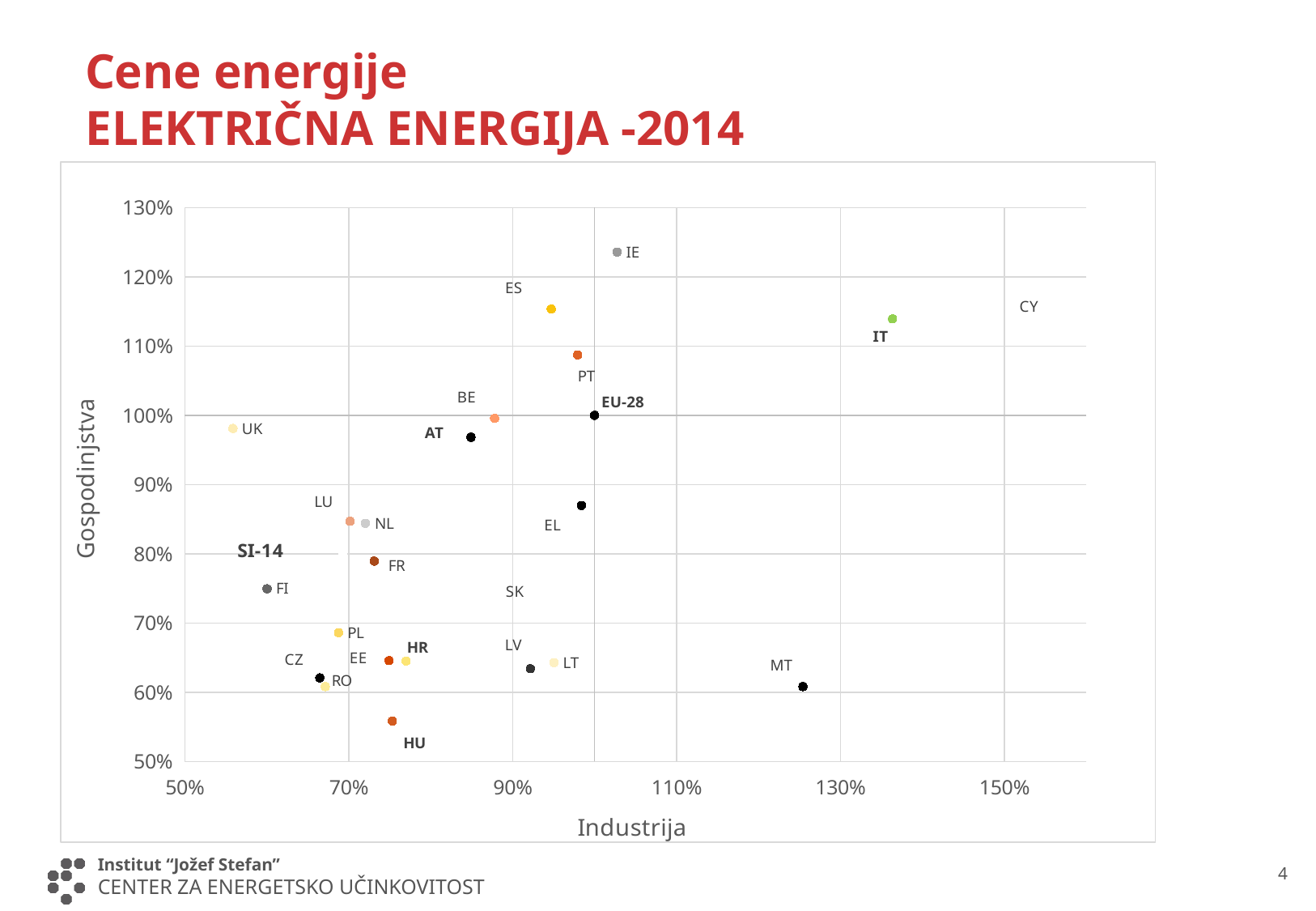
What is the title of the horizontal axis? Industrija Is the Industrija value for IT greater or less than 130%? greater What kind of chart is shown on the slide? scatter chart Which has a higher Gospodinjstva value, PT or EL? PT Which country has the highest Gospodinjstva value? IE Is the Gospodinjstva value for IE greater or less than 120%? greater Is the Industrija value for MT greater or less than 120%? greater Which has a higher Gospodinjstva value, FR or FI? FR Which country has the lowest Industrija value? UK Which country has the lowest Gospodinjstva value? HU